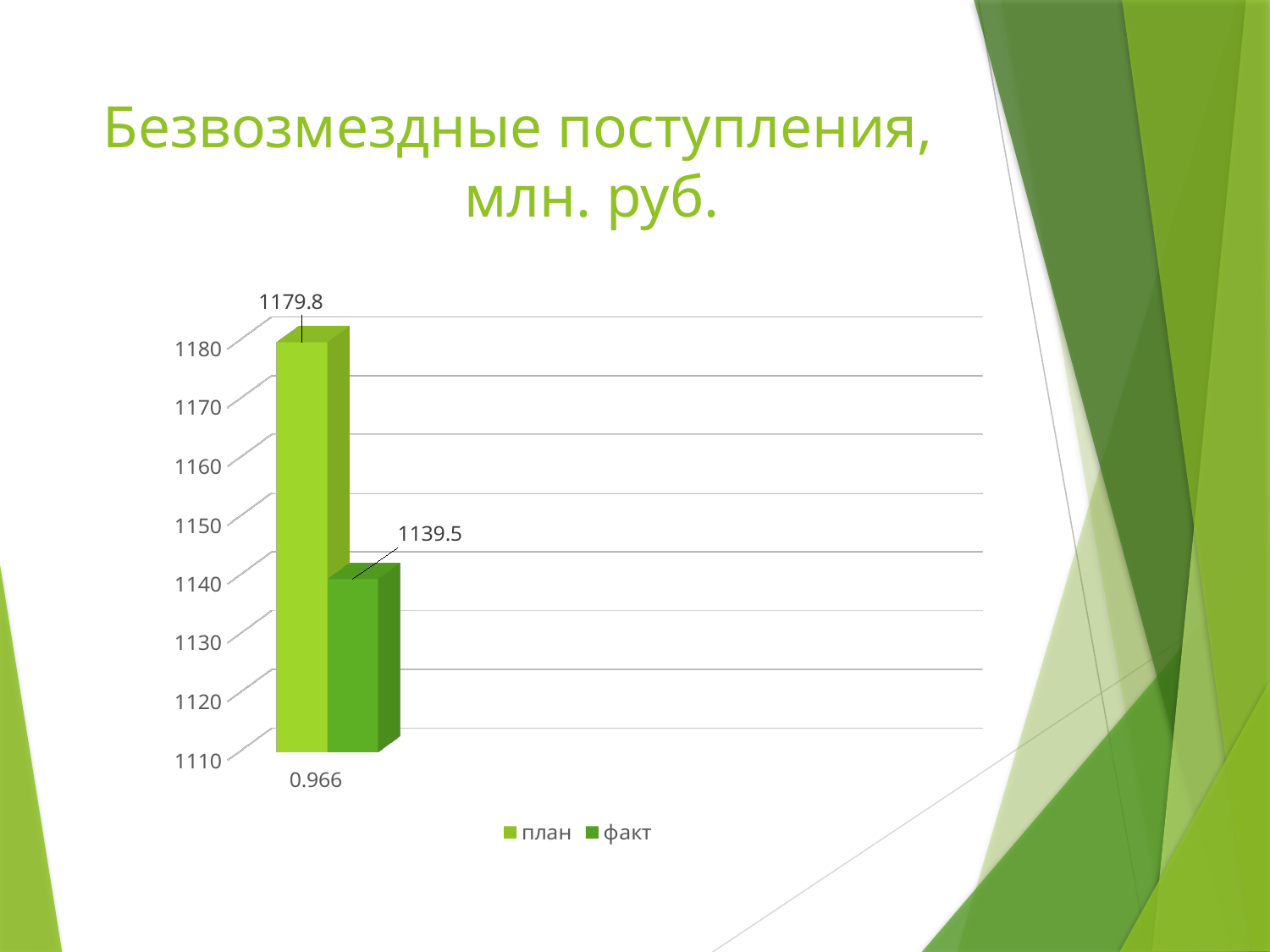
What is the value of the план series? 1179.8 What kind of chart is shown on the slide? bar chart Which series has the lowest value? факт What is the difference between the план and факт values? 40.3 How many series does the legend list? 2 What category label is shown on the x axis? 0.966 Which series has the higher value, план or факт? план Is the value for план greater or less than 1170? greater Is the value for факт greater or less than 1150? less How many categories are shown on the x axis? 1 What is the value of the факт series? 1139.5 What is the title of the chart on the slide? Безвозмездные поступления, млн. руб.